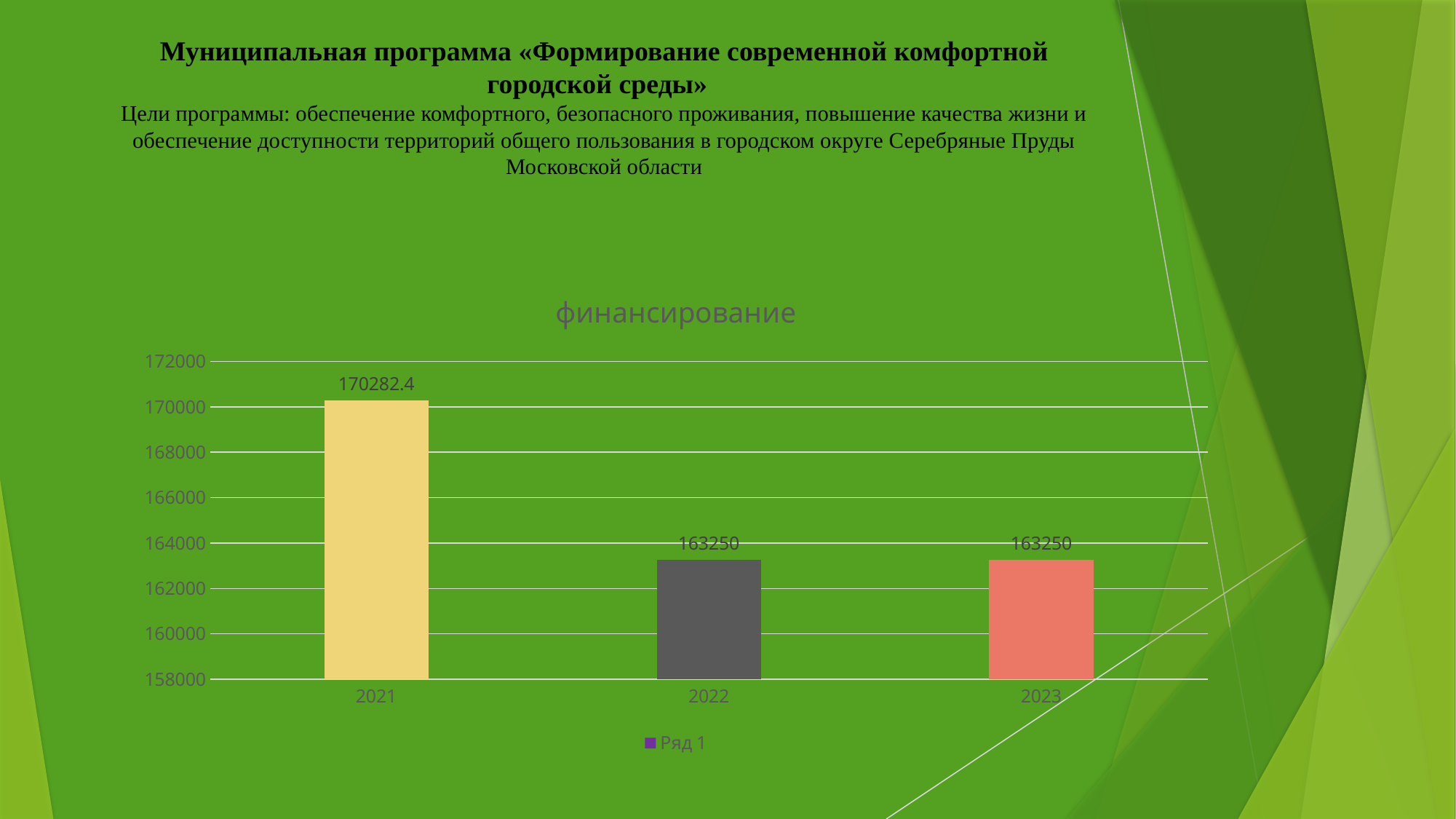
Is the value for 2021 greater or less than 170000? greater How many years are shown on the x axis? 3 Which year has the highest value? 2021 What is the value for 2021? 170282.4 What is the value for 2022? 163250 What is the value for 2023? 163250 What is the difference between the values for 2021 and 2022? 7032.4 Which is larger, the value for 2021 or the value for 2023? 2021 Is the value for 2022 greater or less than 164000? less What kind of chart is shown? bar chart What is the title of the chart? финансирование How many series does the legend list? 1